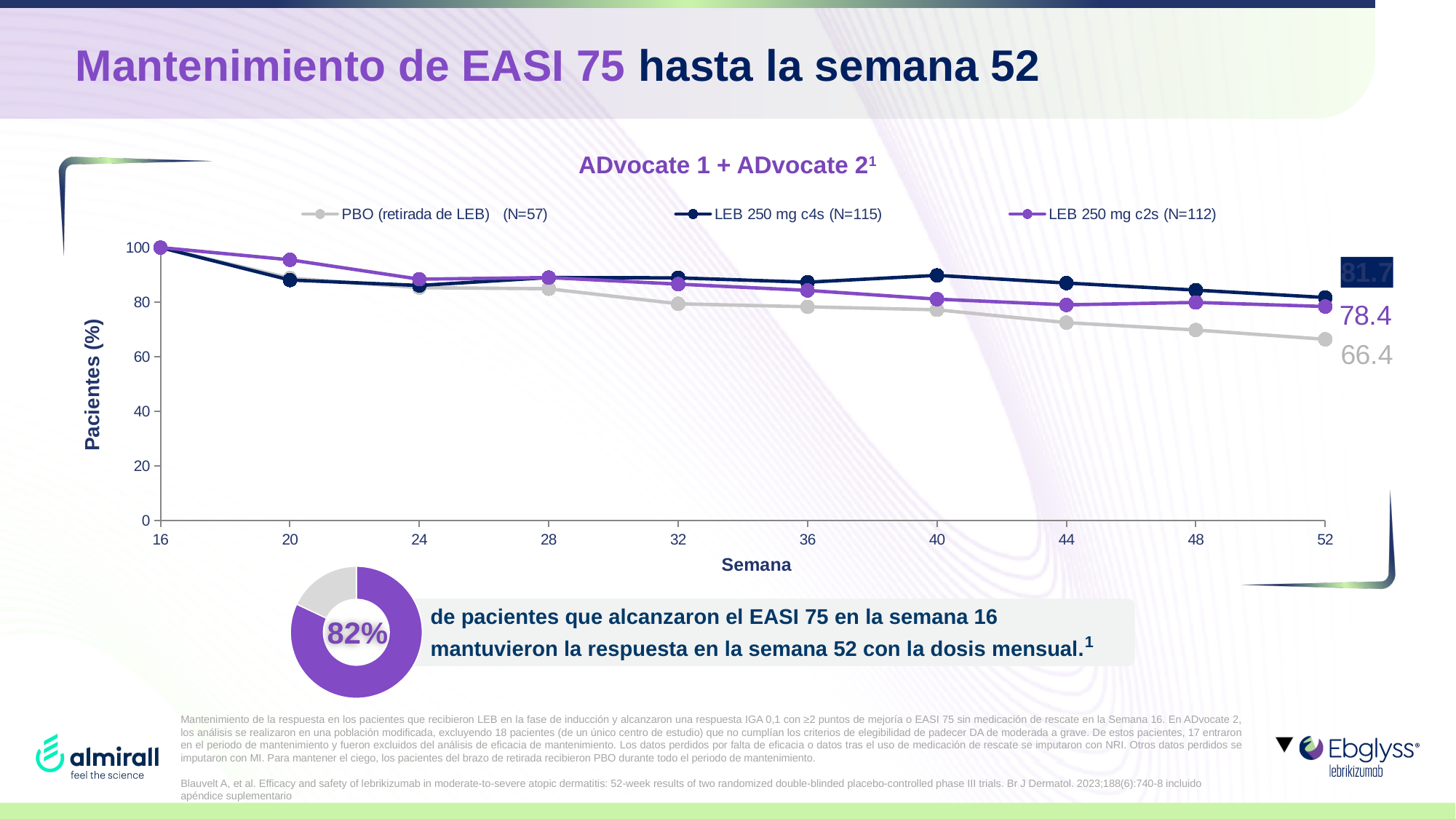
In the line chart, what is the difference between LEB 250 mg c4s and PBO (retirada de LEB) at week 52? 15.3 In the line chart, what is the value for LEB 250 mg c2s (N=112) at week 52? 78.4 In the line chart, which series has the highest value at week 52? LEB 250 mg c4s (N=115) How many week points are plotted along the x axis of the line chart? 10 In the line chart, what is the value for LEB 250 mg c4s (N=115) at week 52? 81.7 In the line chart, is the value for PBO (retirada de LEB) at week 44 greater or less than 80? less In the line chart, what is the value for PBO (retirada de LEB) (N=57) at week 52? 66.4 How many series does the legend of the line chart list? 3 What kind of chart is the main chart titled 'ADvocate 1 + ADvocate 2'? Line chart In the line chart, does the PBO (retirada de LEB) series rise or fall from week 16 to week 52? Fall What percentage does the donut chart below the line chart show? 82% In the line chart, which series has the lowest value at week 52? PBO (retirada de LEB) (N=57)